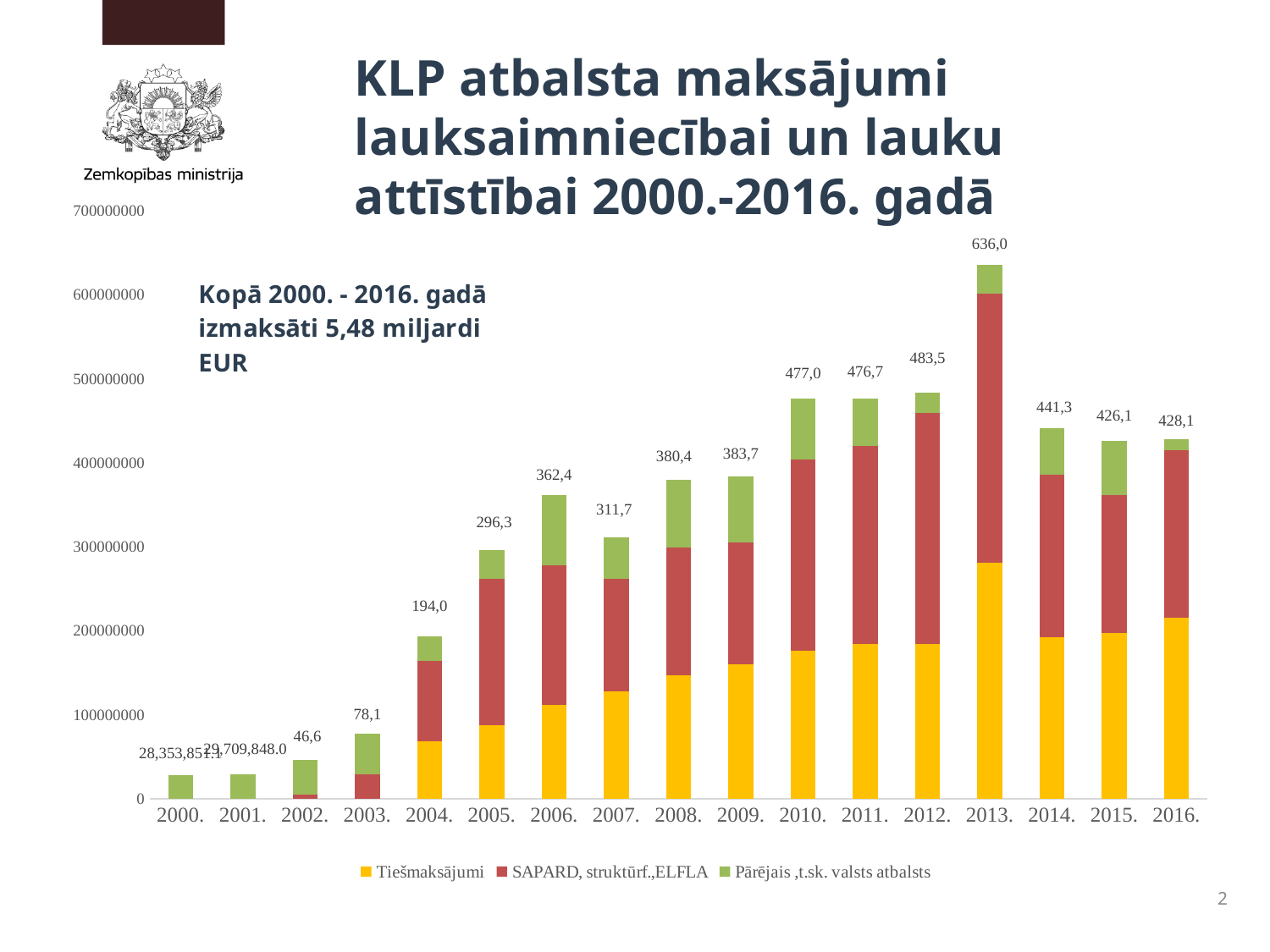
What is the difference between the labelled totals for 2010 and 2009? 93,3 What is the total value labelled for 2005? 296,3 Which year has the larger labelled total, 2007 or 2008? 2008. What is the total value labelled for 2016? 428,1 How many series does the legend list? 3 Do the labelled totals rise or fall from 2004 to 2006? rise What is the difference between the labelled totals for 2013 and 2012? 152,5 How many years are shown on the x axis? 17 Which year has the highest total bar? 2013. Is the Tiešmaksājumi value for 2013 greater or less than 200000000? greater What is the total value labelled for 2013? 636,0 What kind of chart is shown on the slide? Stacked bar chart